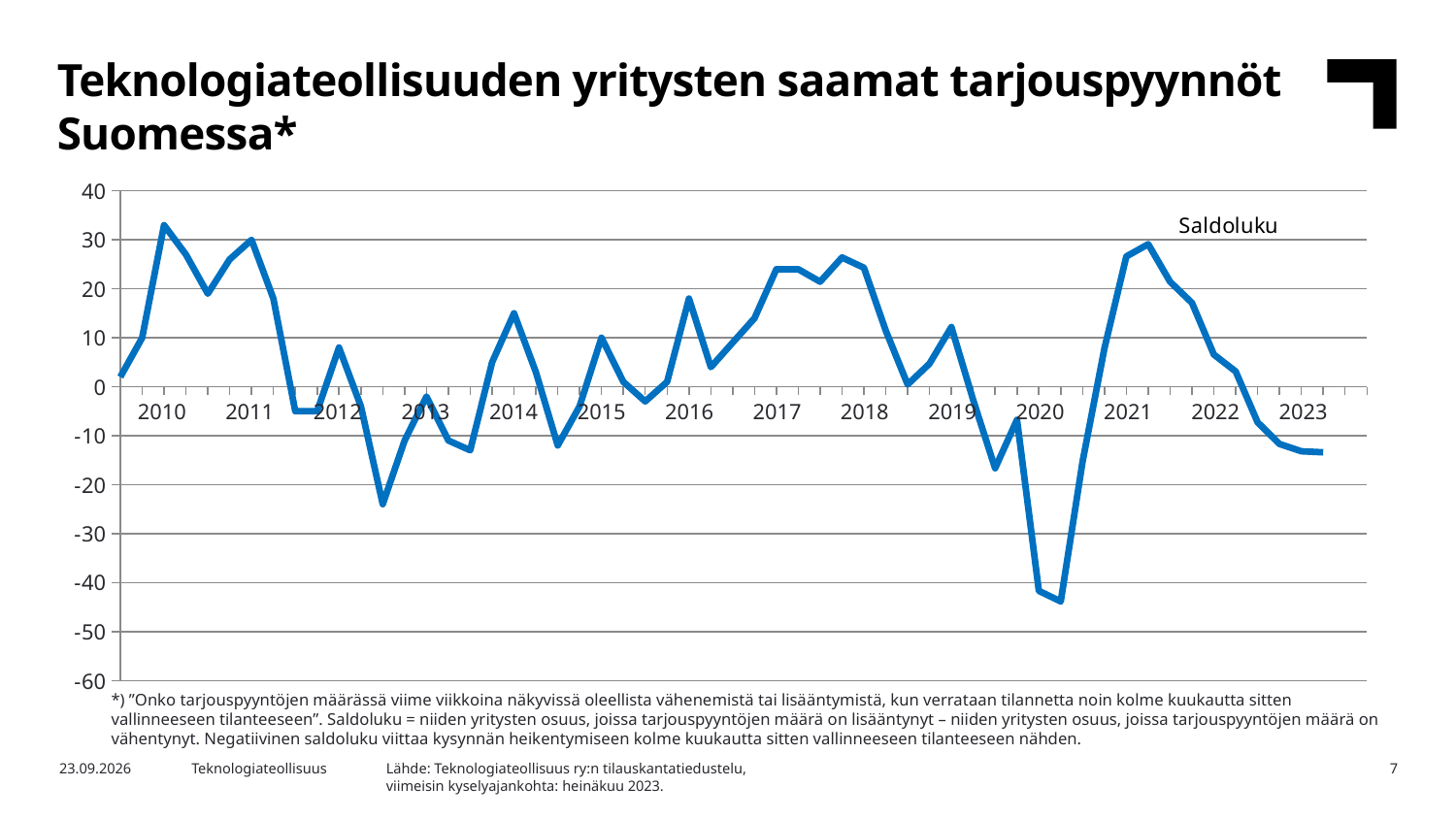
Is the lowest value of the Saldoluku line in 2020 greater or less than -40? less Is the peak value of the Saldoluku line in 2021 greater or less than 20? greater How many series does the chart's legend list? 1 Which is larger, the Saldoluku value at the 2018 peak or the value at the 2020 low point? the 2018 peak Does the Saldoluku line rise or fall from the 2021 peak to the end of 2023? fall What is the title of the slide containing the chart? Teknologiateollisuuden yritysten saamat tarjouspyynnöt Suomessa* In which year does the Saldoluku line reach its lowest point? 2020 Is the lowest value of the Saldoluku line in 2012 greater or less than -20? less Does the Saldoluku line rise or fall between its low point in 2020 and its peak in 2021? rise What is the name of the series shown in the chart legend? Saldoluku What kind of chart is shown on the slide? line chart